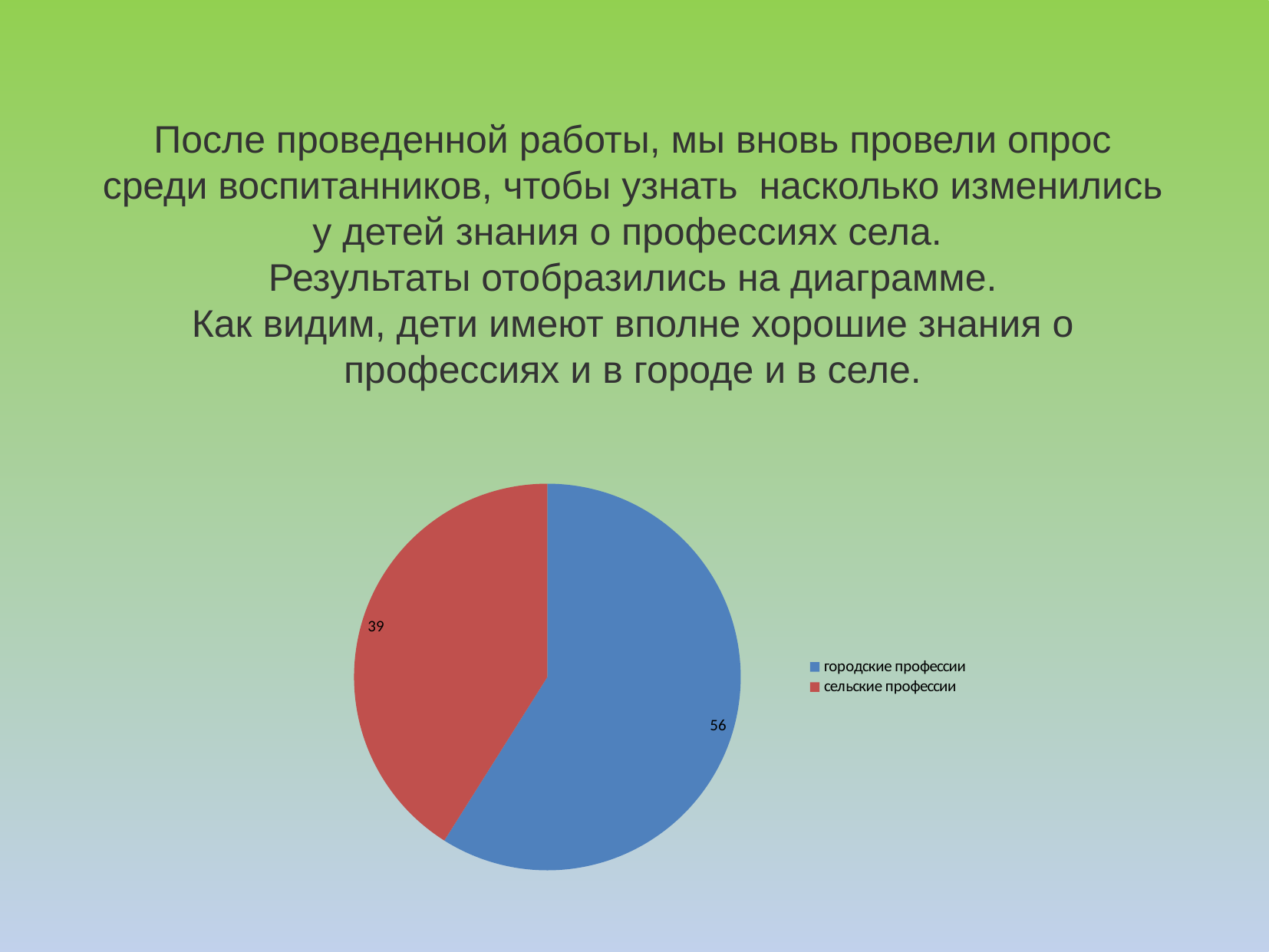
What is the total of the two values shown in the pie chart? 95 What value is shown for сельские профессии in the pie chart? 39 How many slices does the pie chart have? 2 Which category has the largest slice in the pie chart? городские профессии Which is larger: the value for городские профессии or the value for сельские профессии? городские профессии What colour is the slice for городские профессии? blue Which category has the smallest slice in the pie chart? сельские профессии What kind of chart is shown on the slide? pie chart How many entries does the legend of the pie chart list? 2 What colour is the slice for сельские профессии? red What is the difference between the values for городские профессии and сельские профессии? 17 What value is shown for городские профессии in the pie chart? 56